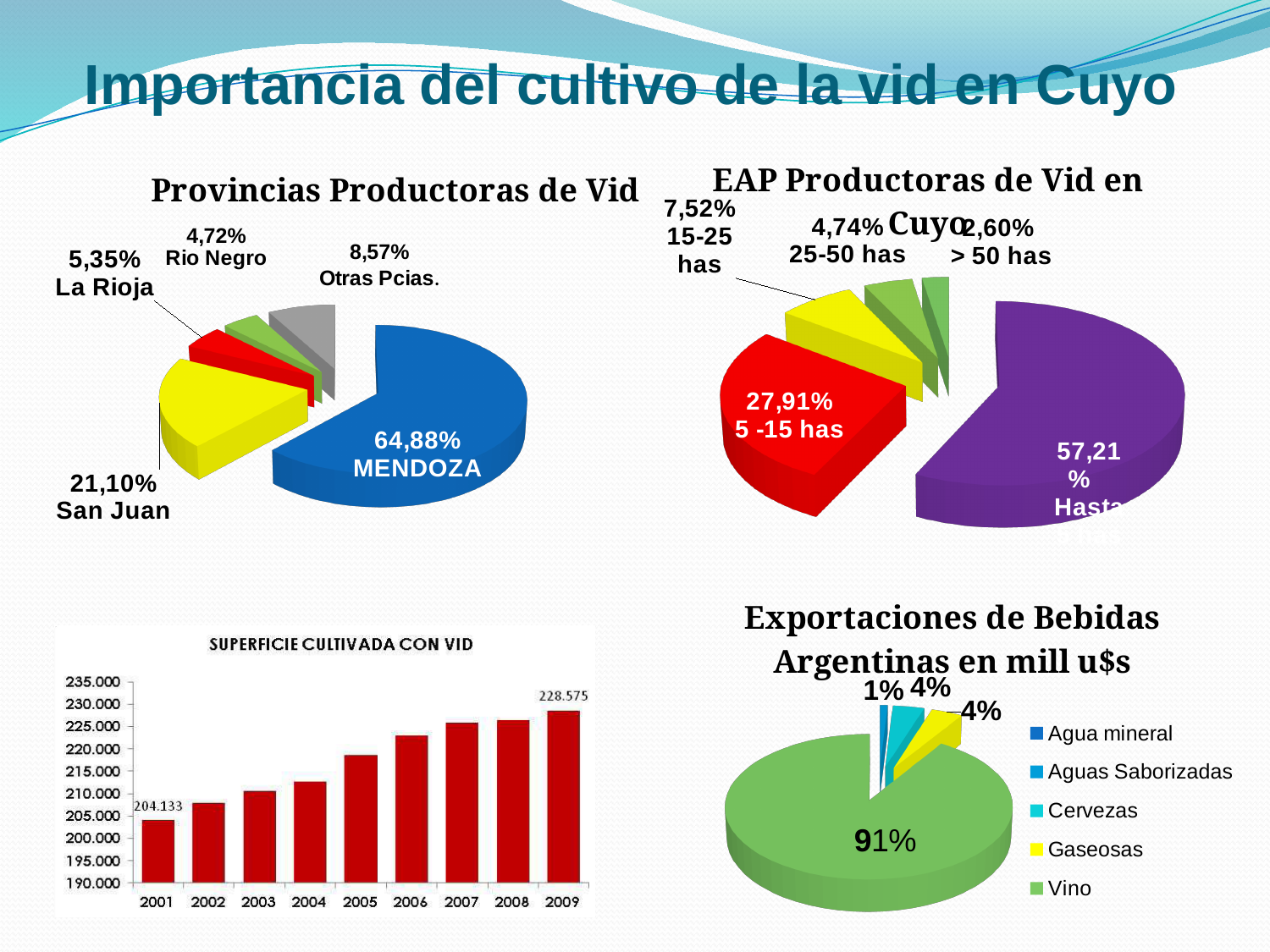
How many slices does the 'Provincias Productoras de Vid' pie chart have? 5 In the 'SUPERFICIE CULTIVADA CON VID' chart, do the values rise or fall from 2001 to 2009? Rise In the 'Provincias Productoras de Vid' chart, which province has the smallest share? Rio Negro What type of chart is 'SUPERFICIE CULTIVADA CON VID'? Bar chart How many entries does the legend of the 'Exportaciones de Bebidas Argentinas en mill u$s' chart list? 5 In the 'SUPERFICIE CULTIVADA CON VID' chart, what is the value for 2009? 228.575 In the 'EAP Productoras de Vid en Cuyo' chart, which category has the largest share? Hasta 5 has In the 'Provincias Productoras de Vid' chart, what share does Mendoza have? 64,88% In the 'EAP Productoras de Vid en Cuyo' chart, which is larger: 15-25 has or 25-50 has? 15-25 has In the 'SUPERFICIE CULTIVADA CON VID' chart, is the value for 2006 greater or less than 220.000? greater In the 'EAP Productoras de Vid en Cuyo' chart, what is the share for 5-15 has? 27,91% In the 'Provincias Productoras de Vid' chart, what is the difference between the shares of Mendoza and San Juan? 43,78%